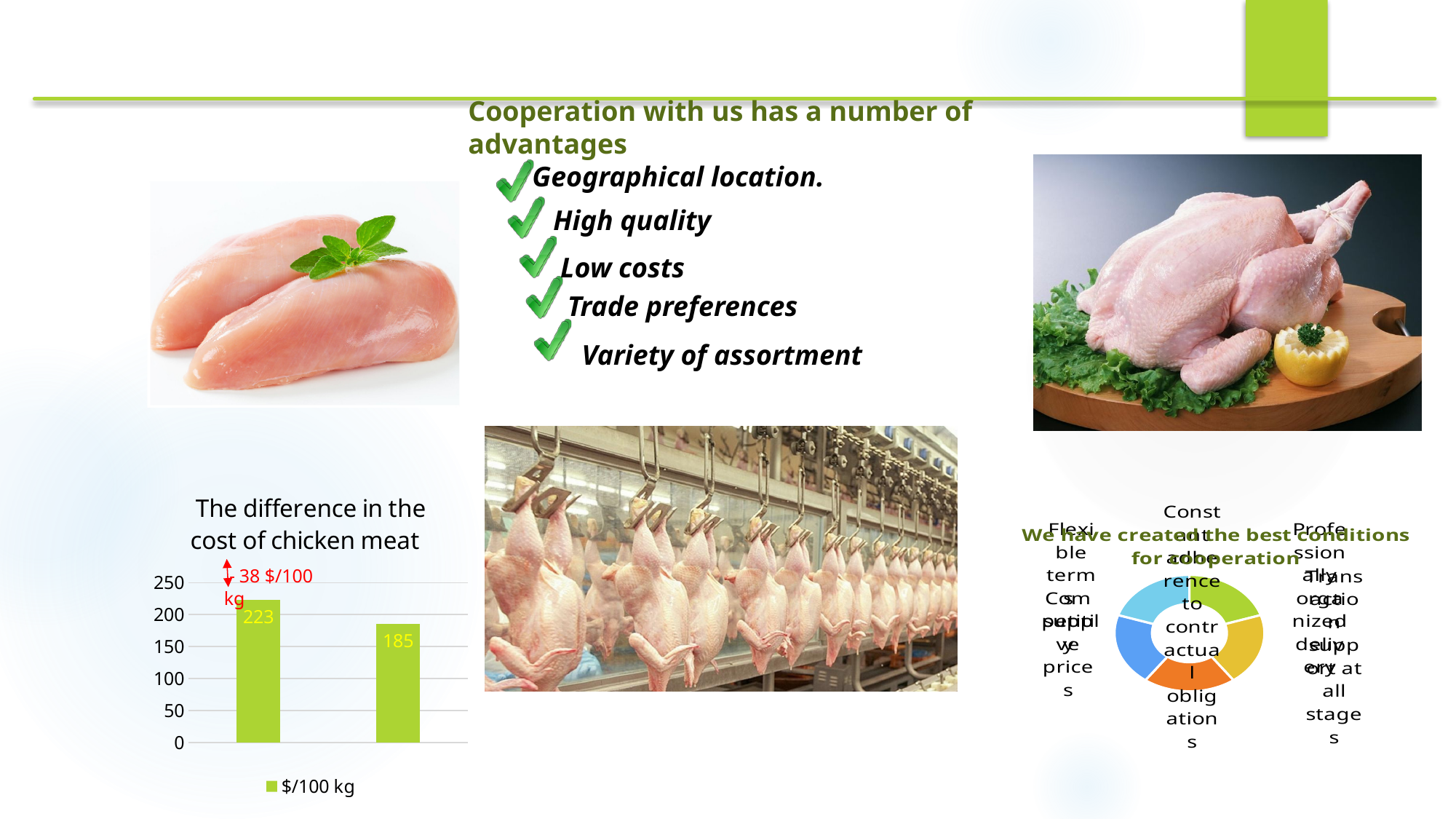
What is the highest value shown on the y axis of the chart "The difference in the cost of chicken meat"? 250 In the chart "The difference in the cost of chicken meat", what is the value of the left bar? 223 What type of chart is "The difference in the cost of chicken meat"? bar chart How many bars are plotted in the chart "The difference in the cost of chicken meat"? 2 In the chart "The difference in the cost of chicken meat", what difference is written in red above the bars? 38 $/100 kg In the chart "The difference in the cost of chicken meat", which bar is taller, the left or the right? left In the chart "The difference in the cost of chicken meat", what is the difference between the two bars? 38 How many series does the legend of the chart "The difference in the cost of chicken meat" list? 1 In the chart "The difference in the cost of chicken meat", what is the value of the right bar? 185 In the chart "The difference in the cost of chicken meat", is the value of the right bar greater or less than 200? less What is the legend entry of the chart "The difference in the cost of chicken meat"? $/100 kg In the chart "The difference in the cost of chicken meat", is the value of the left bar greater or less than 200? greater